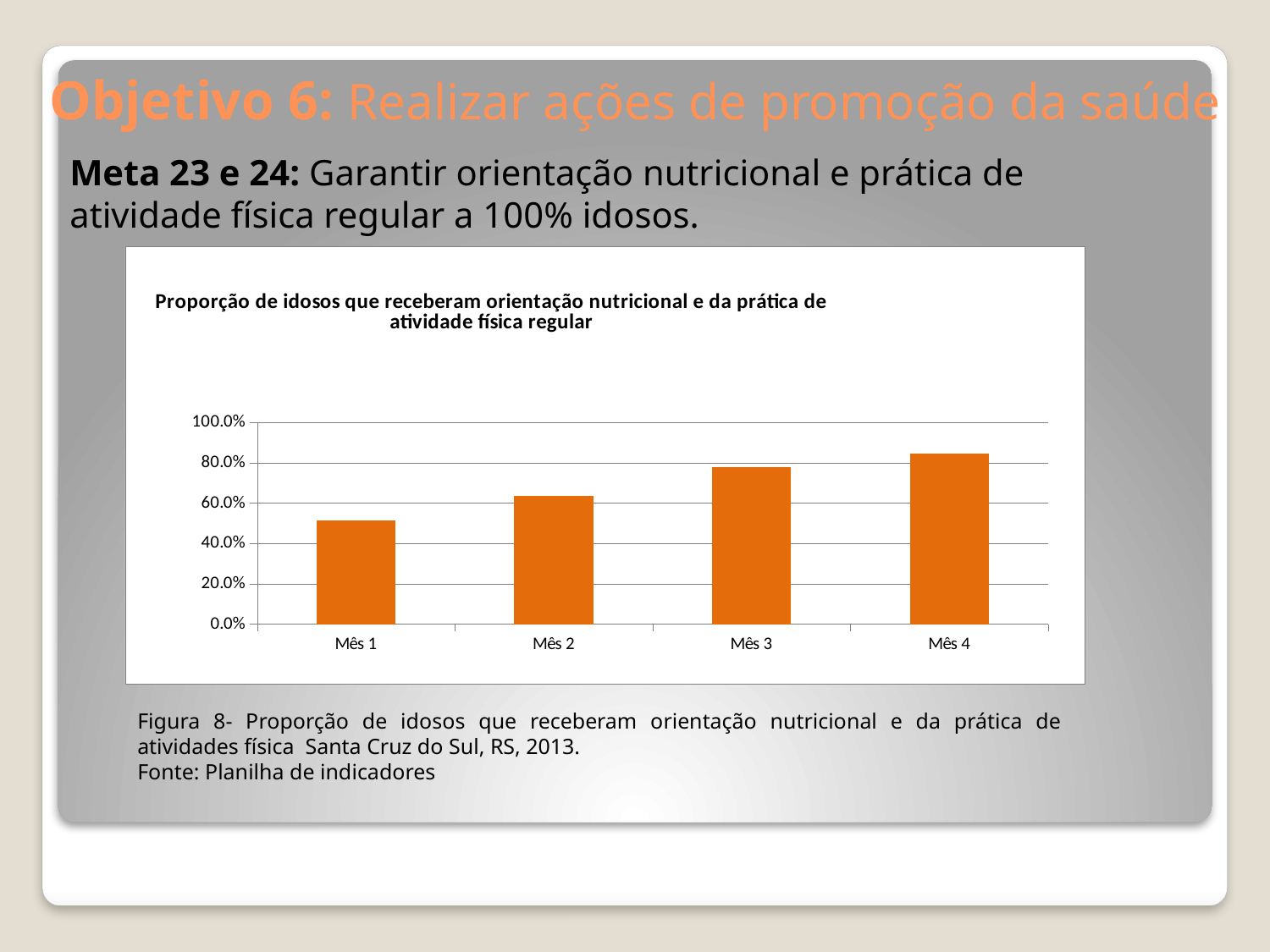
How many months (categories) are plotted on the chart? 4 Which month has the highest proportion of idosos who received orientation? Mês 4 Is the value for Mês 1 greater or less than 60.0%? less Which is larger, the value for Mês 2 or the value for Mês 4? Mês 4 Which month has the lowest proportion of idosos who received orientation? Mês 1 What is the title of the chart? Proporção de idosos que receberam orientação nutricional e da prática de atividade física regular Is the value for Mês 2 greater or less than 80.0%? less Do the values rise or fall from Mês 1 to Mês 4? rise Which is larger, the value for Mês 3 or the value for Mês 1? Mês 3 What kind of chart is shown on the slide? bar chart Is the value for Mês 1 greater or less than 40.0%? greater